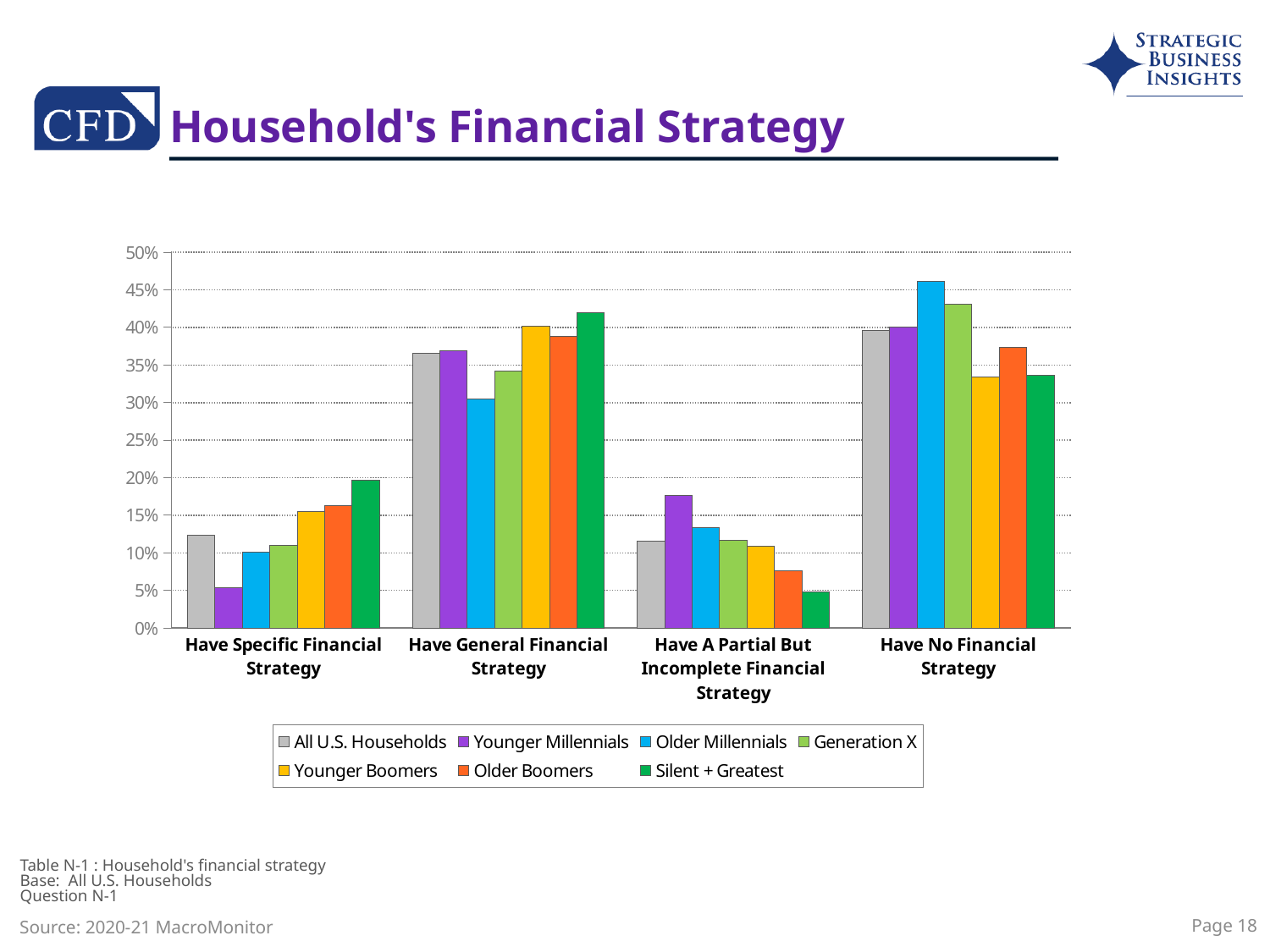
How many financial strategy categories are shown on the x axis? 4 Which group has the lowest bar for 'Have A Partial But Incomplete Financial Strategy'? Silent + Greatest How many series does the legend list? 7 Is the value for Older Millennials under 'Have No Financial Strategy' greater or less than 40%? greater Which group has the highest bar for 'Have Specific Financial Strategy'? Silent + Greatest Which group has the highest bar for 'Have A Partial But Incomplete Financial Strategy'? Younger Millennials Is the value for Younger Millennials under 'Have Specific Financial Strategy' greater or less than 10%? less Which group has the lowest bar for 'Have Specific Financial Strategy'? Younger Millennials Which group has the highest bar for 'Have No Financial Strategy'? Older Millennials What kind of chart is shown on the slide? bar chart Which group has the lowest bar for 'Have General Financial Strategy'? Older Millennials Under 'Have General Financial Strategy', which is larger: the value for Silent + Greatest or the value for Older Millennials? Silent + Greatest